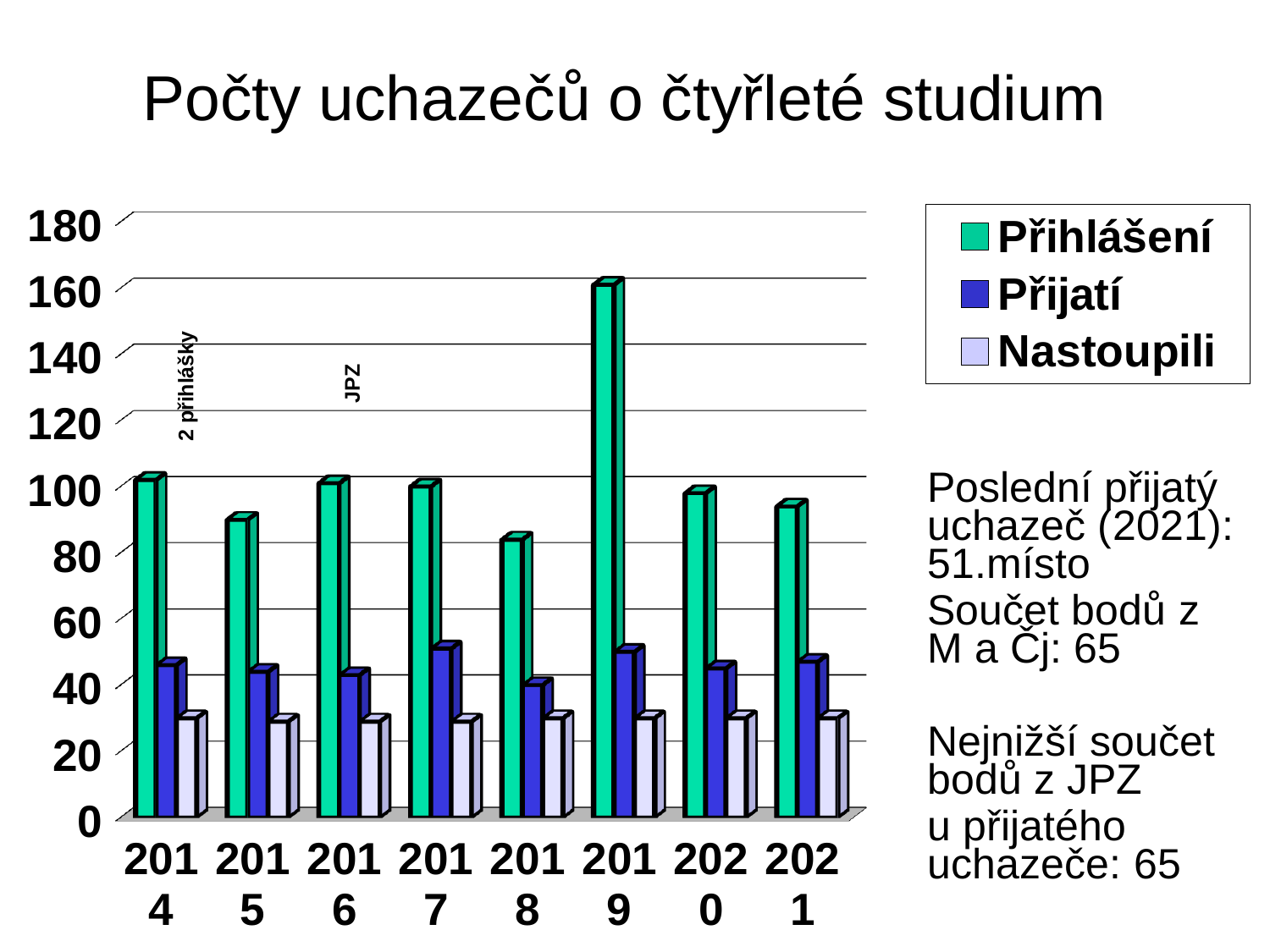
Is the Nastoupili value for 2014 greater or less than 40? less Is the Přijatí value for 2017 greater or less than 60? less What kind of chart is shown on the slide? bar chart What is the title of the slide? Počty uchazečů o čtyřleté studium Is the Přihlášení value for 2018 greater or less than 100? less Which series is shown in green? Přihlášení Which is larger, the Přihlášení value for 2015 or for 2019? 2019 How many series does the legend list? 3 How many years are shown on the x axis? 8 In which year is the Přihlášení value highest? 2019 In which year is the Přihlášení value lowest? 2018